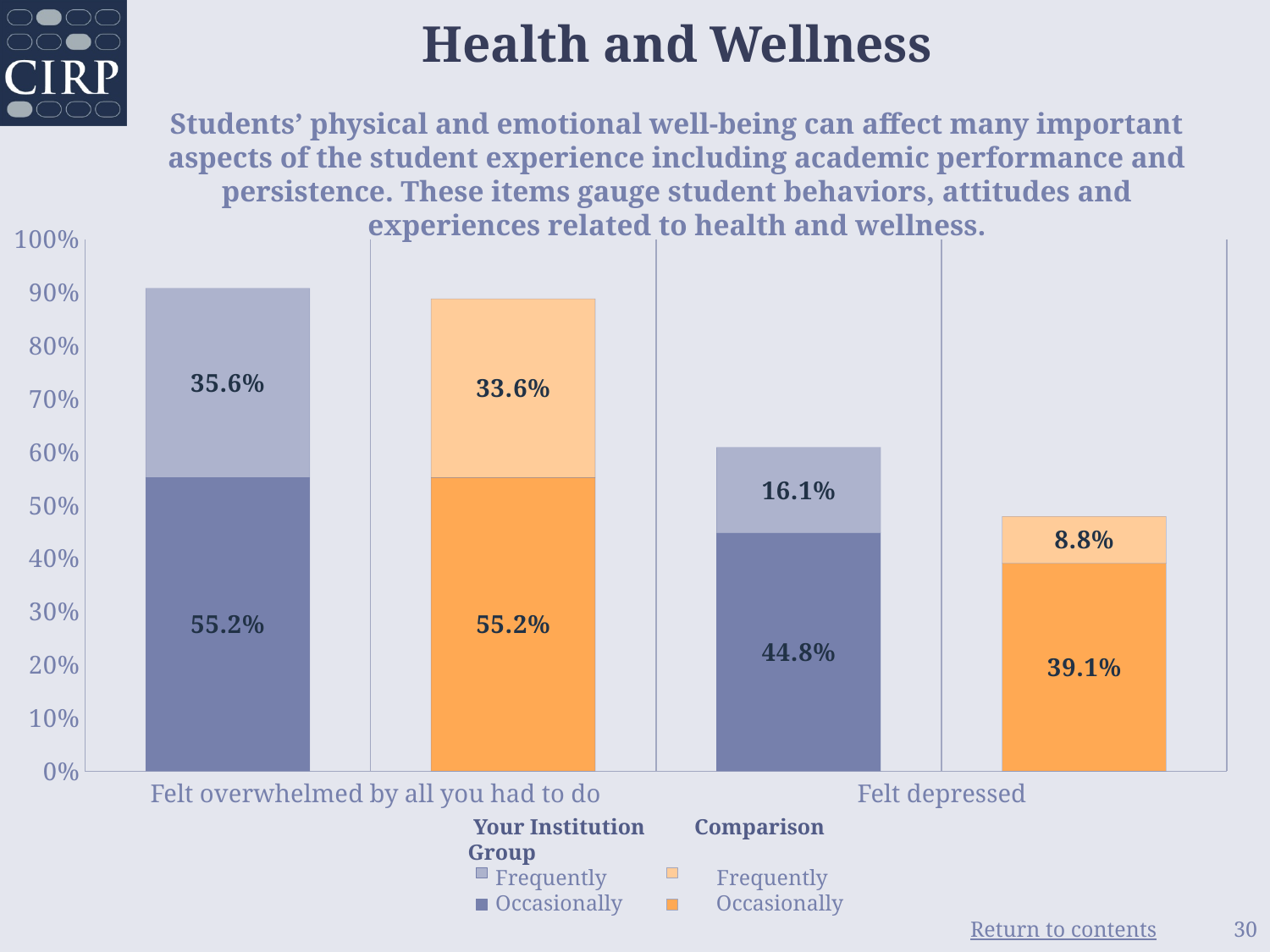
What is the difference between the Your Institution and Comparison Group percentages for frequently feeling depressed? 7.3% What is the total percentage of students in the Comparison Group who felt depressed (frequently plus occasionally)? 47.9% What kind of chart is shown on the slide? Stacked bar chart Which is larger for frequently feeling overwhelmed: Your Institution or the Comparison Group? Your Institution What percentage of students in the Comparison Group reported frequently feeling depressed? 8.8% What percentage of students in the Comparison Group reported occasionally feeling depressed? 39.1% How many items (categories) are shown on the x axis? 2 Which of the two items has the lowest total stacked bar for the Comparison Group? Felt depressed What percentage of students at Your Institution reported frequently feeling overwhelmed by all they had to do? 35.6% What percentage of students at Your Institution reported occasionally feeling overwhelmed by all they had to do? 55.2% What is the total percentage of students at Your Institution who felt overwhelmed by all they had to do (frequently plus occasionally)? 90.8% How many series does the legend list? 4